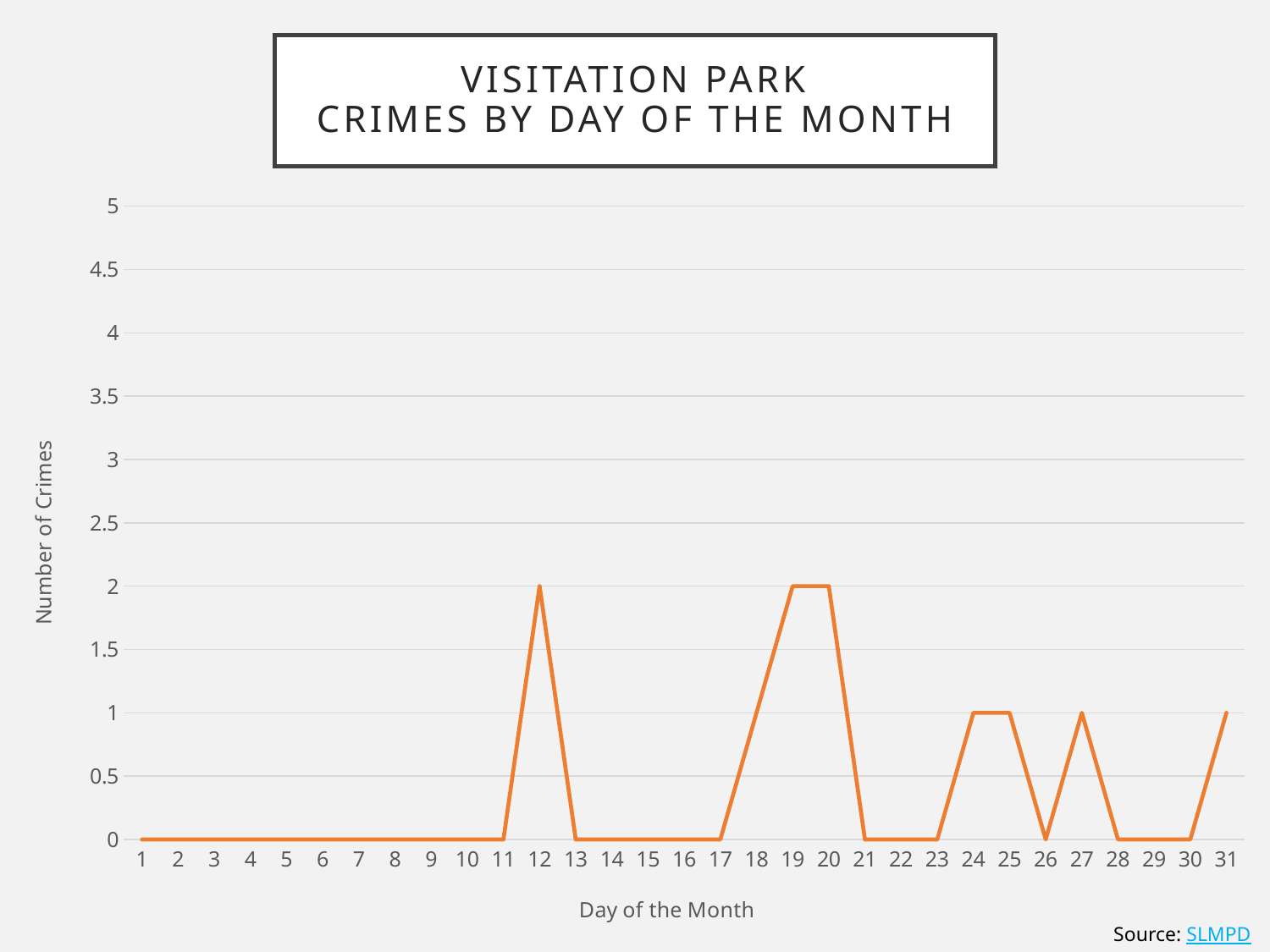
Which day has more crimes, day 12 or day 25? day 12 What is the label of the y axis? Number of Crimes What is the number of crimes on day 5? 0 What is the highest number of crimes recorded on any single day? 2 What is the number of crimes on day 19? 2 What is the number of crimes on day 12? 2 What kind of chart is shown on the slide? line chart How many days of the month are shown on the x axis? 31 What is the number of crimes on day 24? 1 What is the number of crimes on day 31? 1 What is the title of the chart? Visitation Park Crimes by Day of the Month What is the difference in the number of crimes between day 20 and day 27? 1